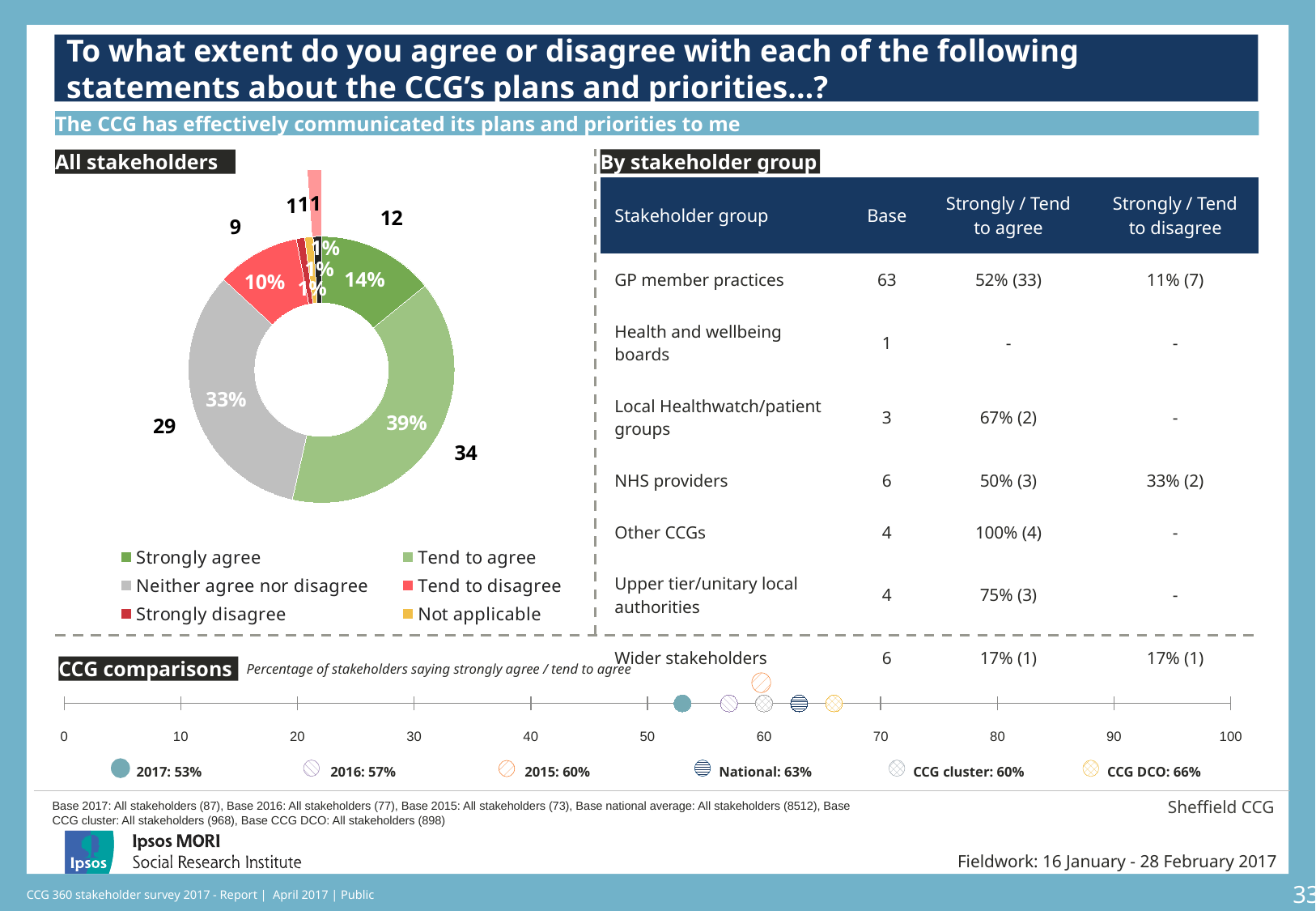
In the All stakeholders donut chart, which is larger: Neither agree nor disagree or Tend to disagree? Neither agree nor disagree In the All stakeholders donut chart, what percentage tend to disagree? 10% In the All stakeholders donut chart, what percentage neither agree nor disagree? 33% What type of chart is used for the All stakeholders section? Donut chart How many entries does the legend of the All stakeholders donut chart list? 6 In the CCG comparisons chart, what is the difference in percentage points between the National figure and the 2017 figure? 10 In the All stakeholders donut chart, which response category has the largest share? Tend to agree In the All stakeholders donut chart, what percentage of stakeholders tend to agree? 39% In the All stakeholders donut chart, what is the difference in percentage points between Tend to agree and Strongly agree? 25 In the CCG comparisons chart, which comparator has the highest percentage? CCG DCO: 66% In the All stakeholders donut chart, what percentage of stakeholders strongly agree? 14% In the CCG comparisons chart, what percentage of stakeholders said strongly agree / tend to agree in 2017? 53%